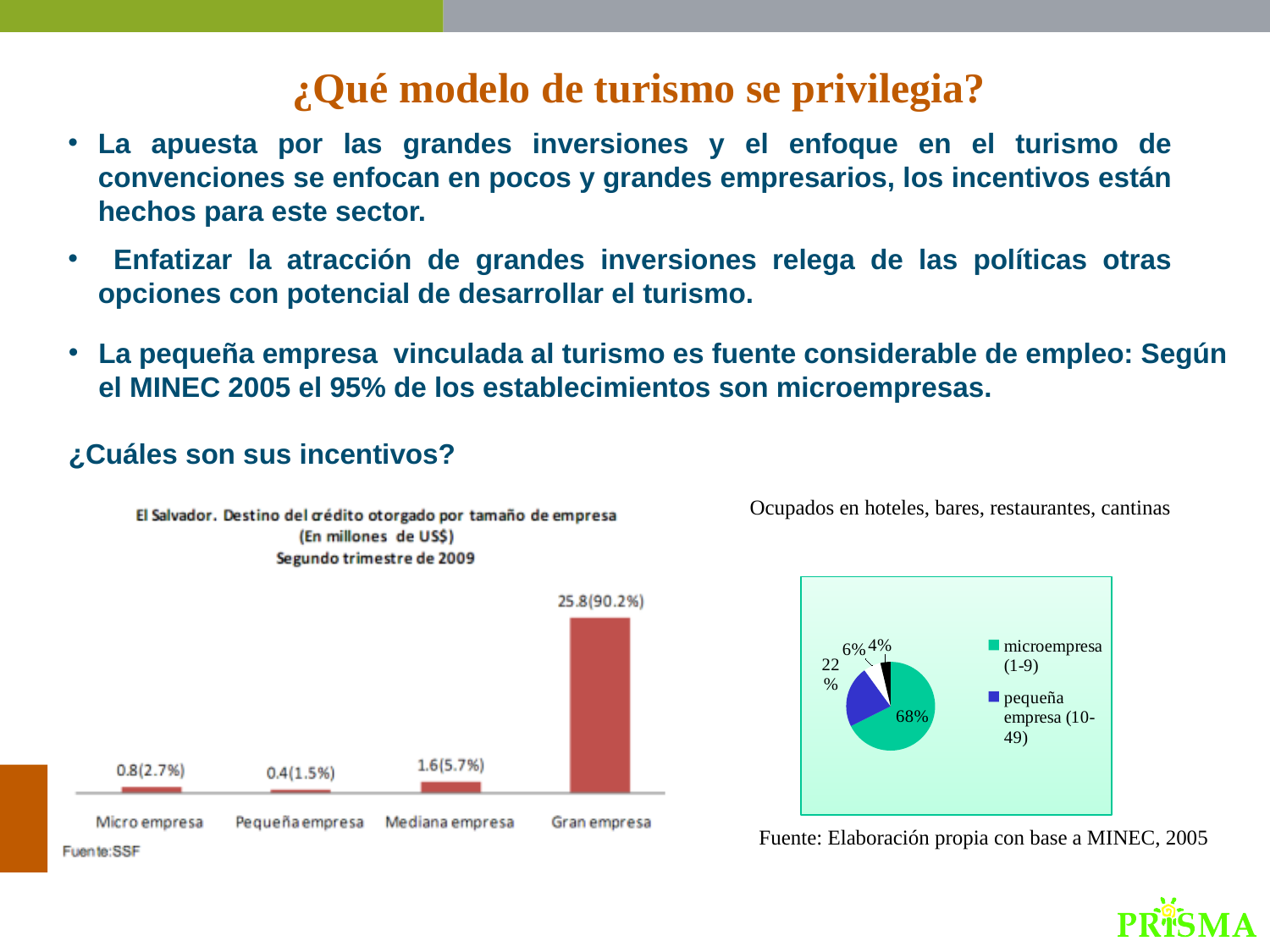
In the bar chart on the left, what is the value for Gran empresa? 25.8(90.2%) How many categories are shown in the bar chart on the left? 4 In the pie chart on the right, what share does microempresa (1-9) have? 68% In the bar chart on the left, what is the difference in millions of US$ between Mediana empresa and Micro empresa? 0.8 What kind of chart is the chart on the left of the slide? Bar chart What is the source cited below the bar chart on the left? SSF In the bar chart on the left, what is the value for Mediana empresa? 1.6(5.7%) In the bar chart on the left, what is the value for Pequeña empresa? 0.4(1.5%) In the bar chart on the left, which category has the lowest value? Pequeña empresa In the bar chart on the left, which is larger, the value for Micro empresa or for Mediana empresa? Mediana empresa In the bar chart on the left, which category has the highest value? Gran empresa In the pie chart on the right, what share does pequeña empresa (10-49) have? 22%